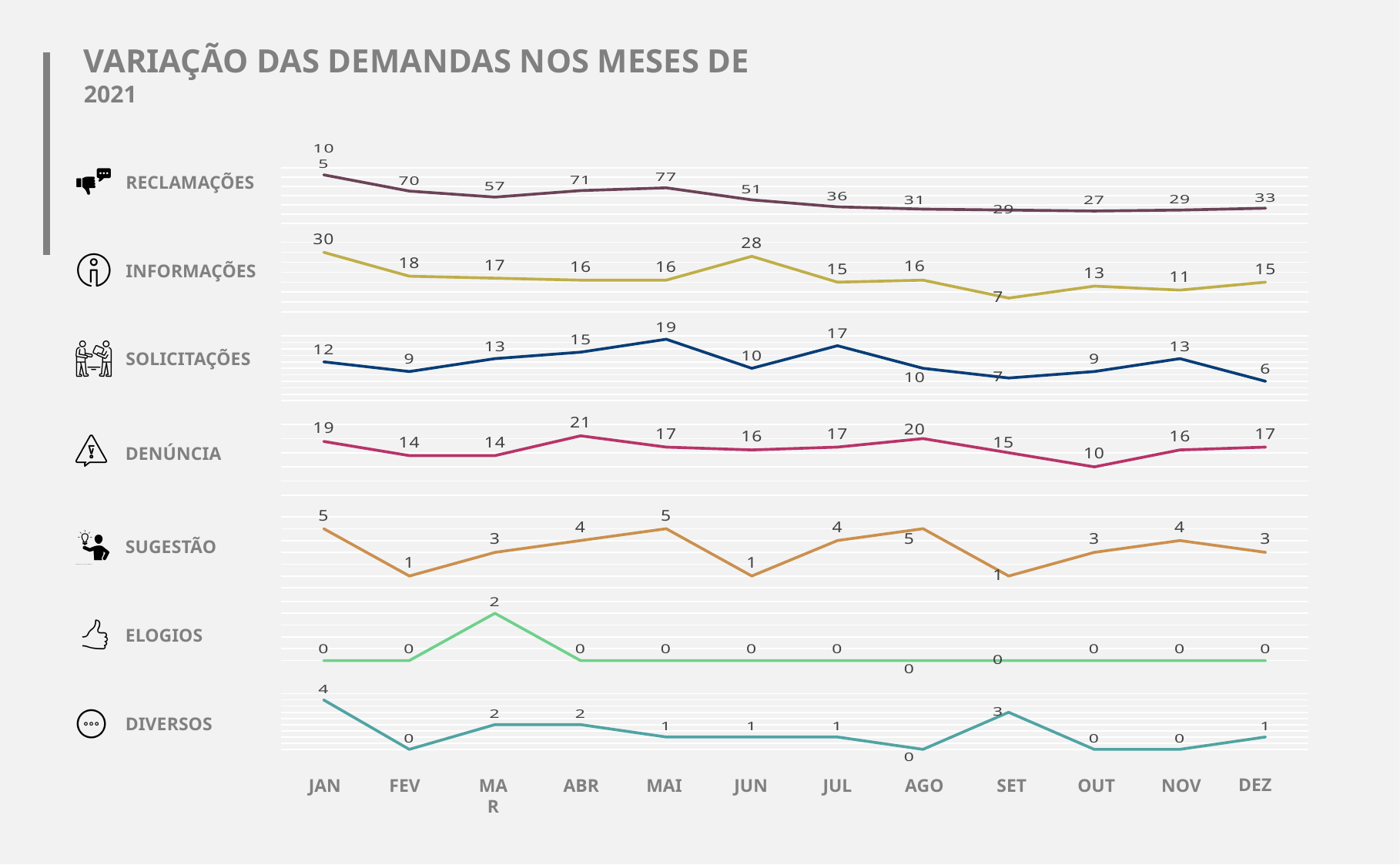
What is the value for SOLICITAÇÕES in DEZ? 6 What is the title of the chart? VARIAÇÃO DAS DEMANDAS NOS MESES DE 2021 Which is larger, SOLICITAÇÕES in MAI or SOLICITAÇÕES in JUL? SOLICITAÇÕES in MAI In which month is DENÚNCIA highest? ABR What is the value for RECLAMAÇÕES in MAI? 77 In which month does ELOGIOS have a non-zero value? MAR In which month is INFORMAÇÕES lowest? SET What is the difference between RECLAMAÇÕES in FEV and in MAR? 13 How many months are shown along the x axis? 12 What is the value for INFORMAÇÕES in JUN? 28 What type of chart is shown on the slide? line chart How many series (demand categories) are plotted on the chart? 7